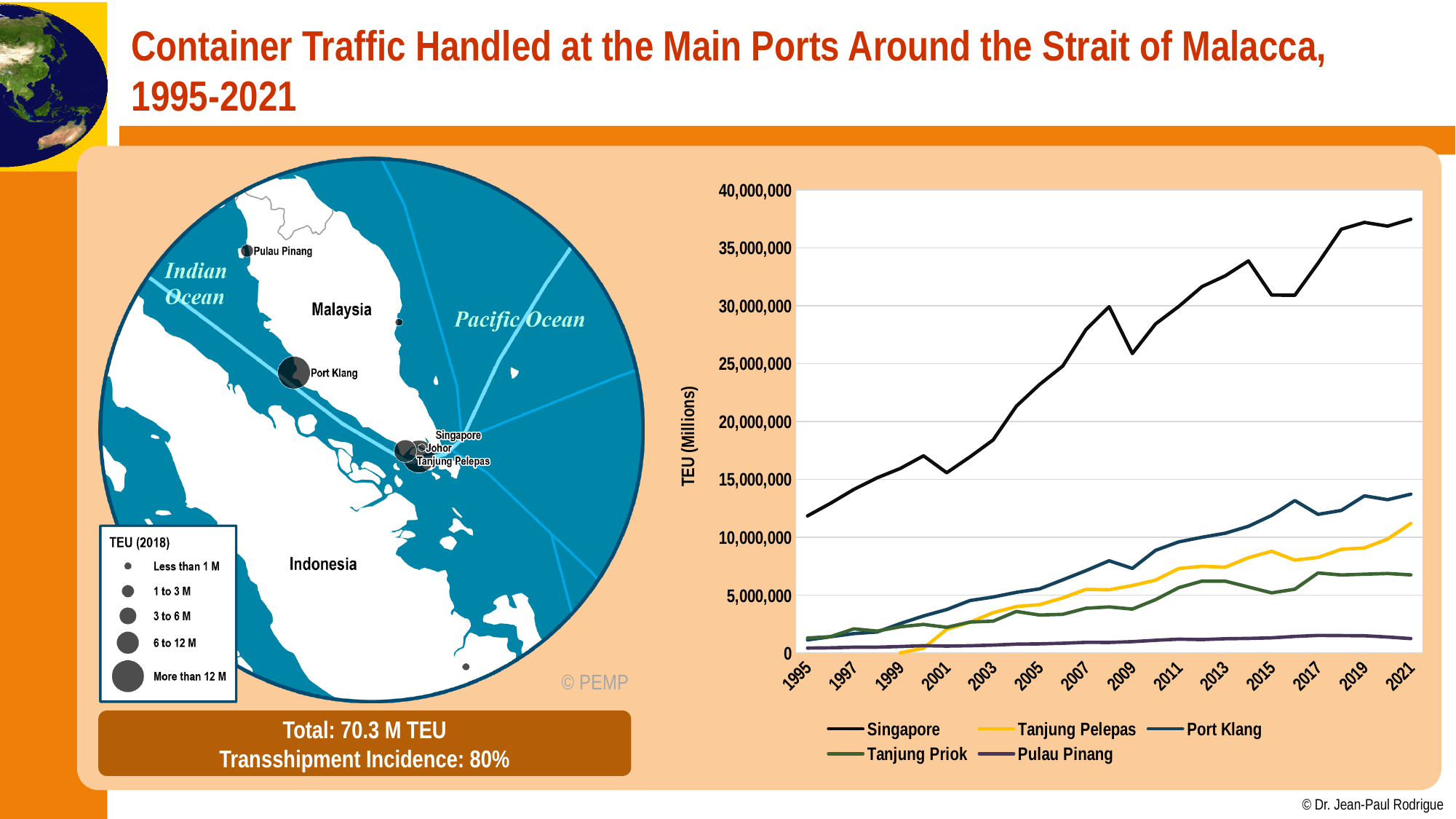
Is the value for Pulau Pinang in 2021 greater or less than 5,000,000? less Is the value for Singapore in 1995 greater or less than 10,000,000? greater How many series does the legend of the line chart list? 5 Is the value for Port Klang in 2021 greater or less than 15,000,000? less What colour is the Tanjung Pelepas line in the chart? yellow Which port has the highest container traffic in 2021 in the line chart? Singapore What kind of chart is shown on the right side of the slide? line chart What is the label on the y axis of the line chart? TEU (Millions) Does the Singapore line generally rise or fall from 1995 to 2021? rise In 2021, which is larger in the line chart: Port Klang or Tanjung Pelepas? Port Klang Which port has the lowest container traffic in 2021 in the line chart? Pulau Pinang